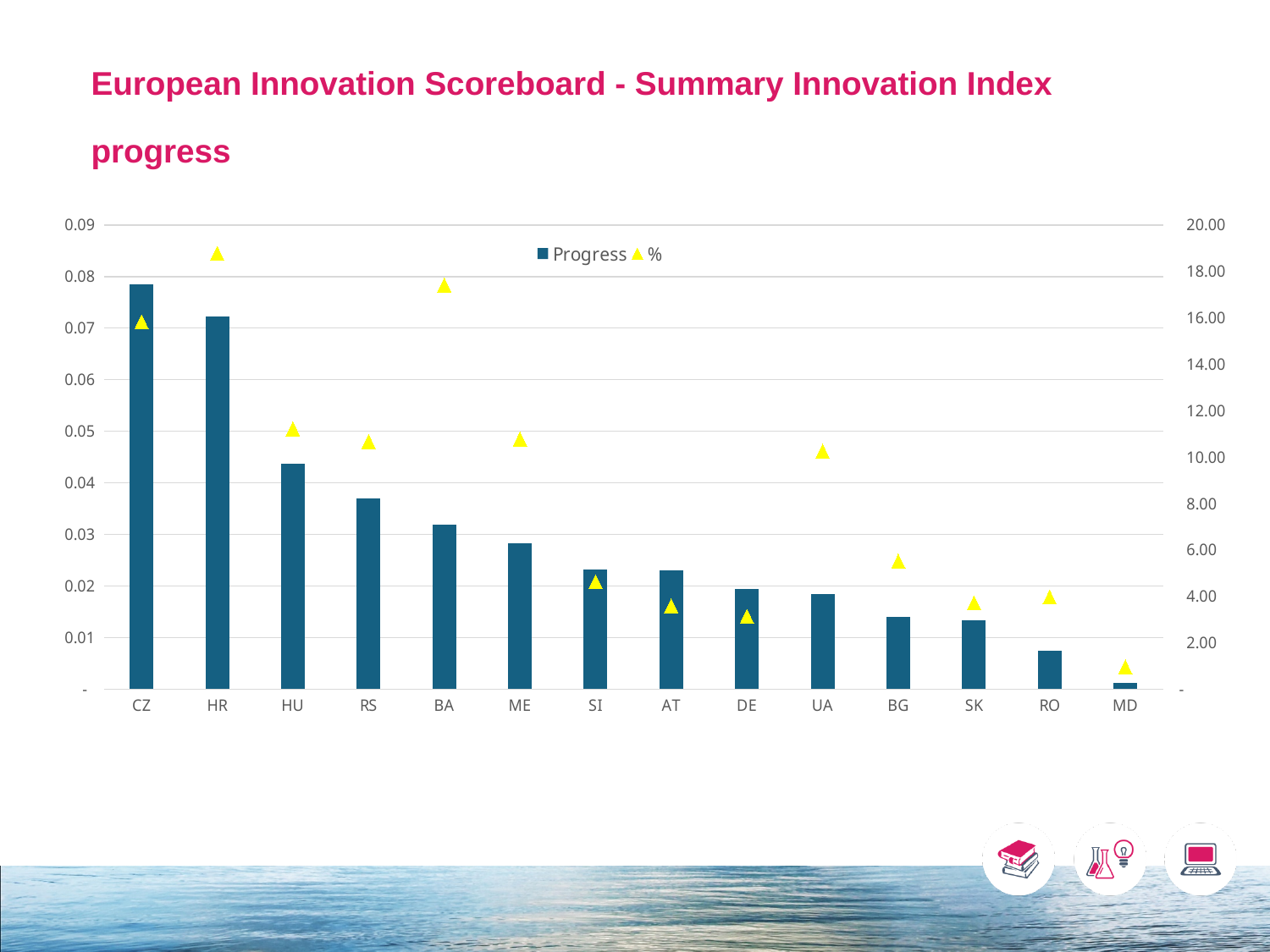
Which country has the highest % marker (yellow triangle)? HR Which has the larger Progress bar, HR or HU? HR Which country has the highest Progress bar? CZ What are the two entries in the chart's legend? Progress and % Is the % value for BA greater or less than 16.00? greater Is the Progress value for HU greater or less than 0.04? greater Is the Progress value for RS greater or less than 0.04? less Do the Progress bars rise or fall from left to right along the x axis? fall What kind of chart is shown on the slide? combination chart (bars with triangle markers) How many countries are shown along the x axis of the chart? 14 How many series does the chart's legend list? 2 Which country has the lowest Progress bar? MD